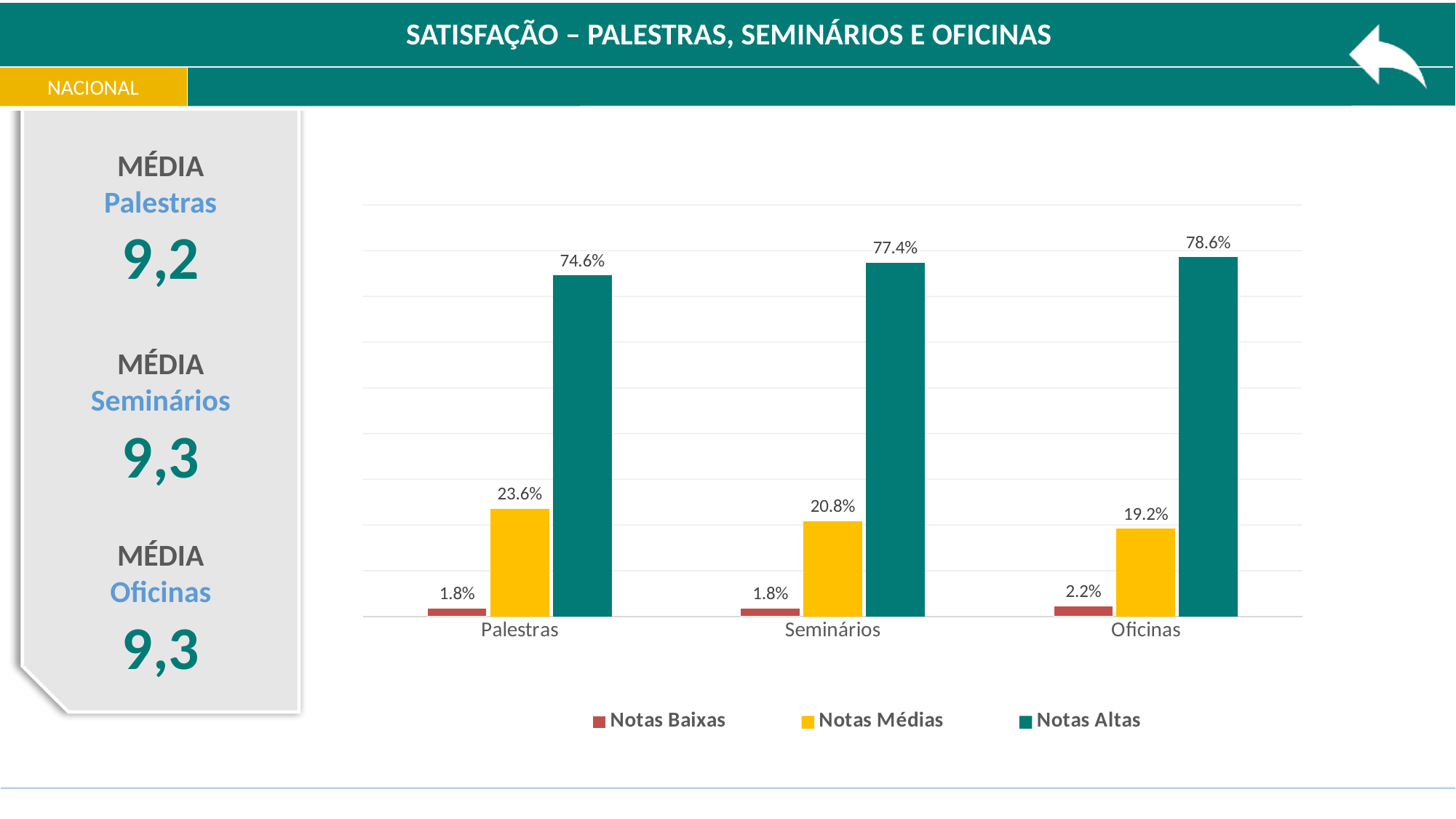
Do the Notas Altas values rise or fall from Palestras to Oficinas? Rise What is the difference between the Notas Altas values for Oficinas and Palestras? 4.0% What kind of chart is shown on the slide? Bar chart Which category has the lowest Notas Médias value? Oficinas How many series does the legend list? 3 Which category has the highest Notas Altas value? Oficinas Which is larger, Notas Médias for Seminários or Notas Médias for Oficinas? Notas Médias for Seminários How many categories are shown on the x axis? 3 What is the value of Notas Altas for Oficinas? 78.6% What is the value of Notas Médias for Palestras? 23.6% What is the value of Notas Baixas for Seminários? 1.8% Which colour represents the Notas Baixas series in the legend? Red